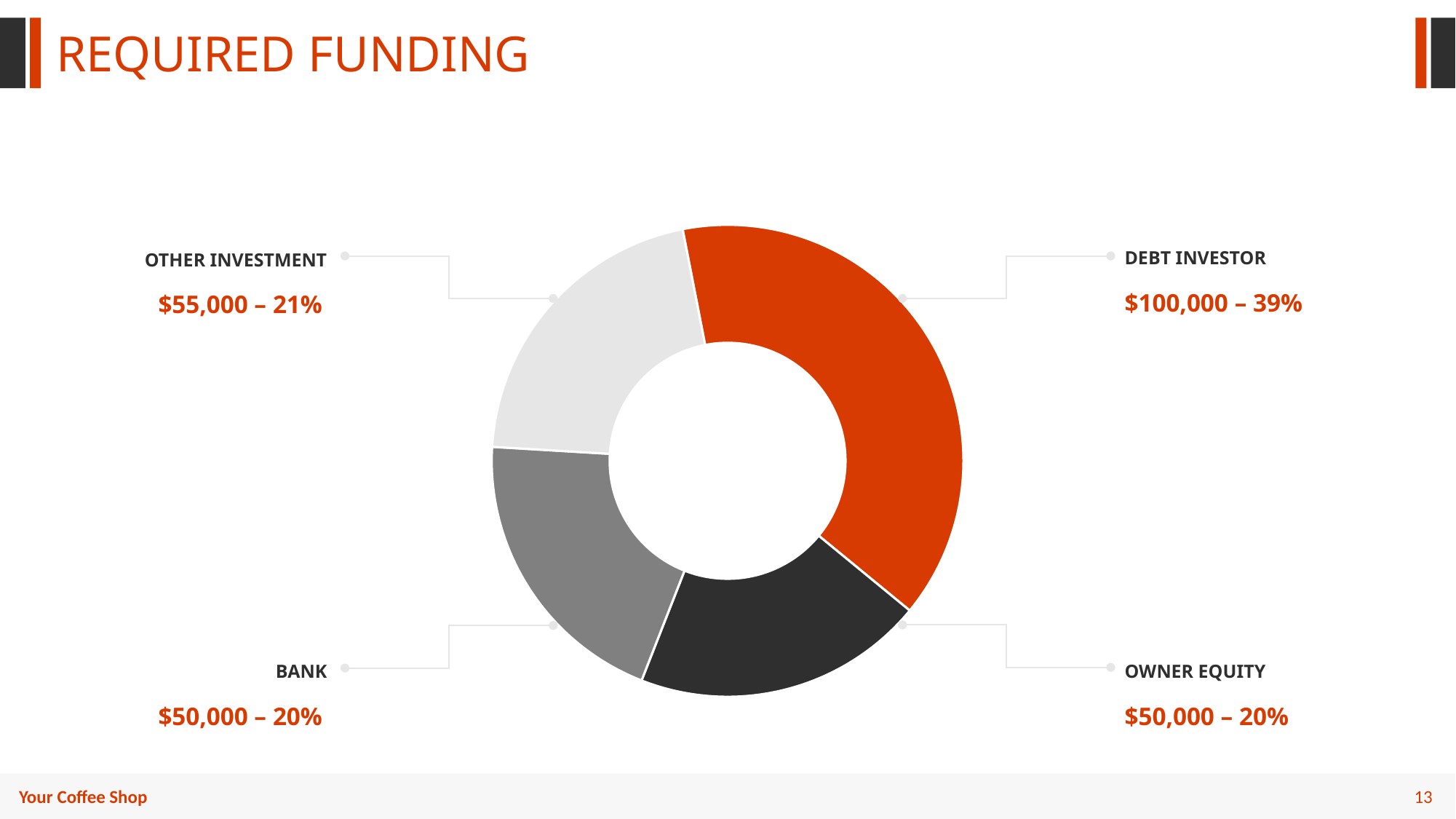
What is the funding amount from the Bank? $50,000 What is the title of the chart slide? REQUIRED FUNDING Which is larger, the Debt Investor amount or the Other Investment amount? Debt Investor What is the funding amount from the Debt Investor? $100,000 Which colour is used for the Debt Investor segment? Orange How many funding sources are shown in the chart? 4 Which funding source provides the largest amount? Debt Investor What is the funding amount from Other Investment? $55,000 What share of the required funding comes from Owner Equity? 20% What share of the required funding comes from the Debt Investor? 39% What is the difference between the Debt Investor amount and the Other Investment amount? $45,000 What kind of chart is shown on the slide? Pie chart (donut)